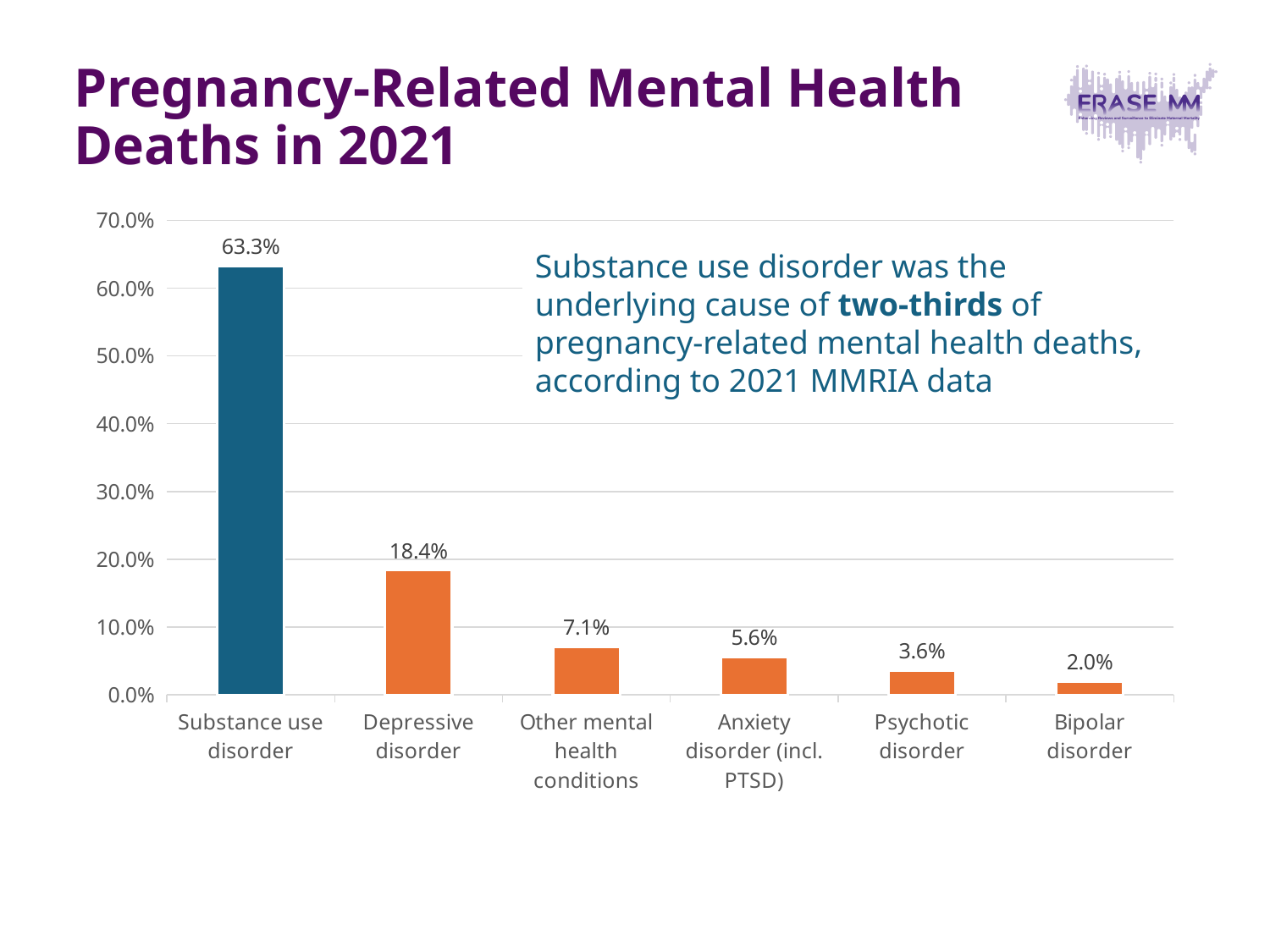
Which category has the highest value? Substance use disorder How many categories are shown on the x axis? 6 What kind of chart is shown on the slide? bar chart What is the value for Depressive disorder? 18.4% What is the value for Anxiety disorder (incl. PTSD)? 5.6% Which is larger, the value for Other mental health conditions or the value for Psychotic disorder? Other mental health conditions Do the values rise or fall from left to right along the x axis? fall Is the value for Depressive disorder greater or less than 20.0%? less Which category has the lowest value? Bipolar disorder What is the difference between the values for Substance use disorder and Depressive disorder? 44.9% What is the value for Bipolar disorder? 2.0% What is the value for Substance use disorder? 63.3%